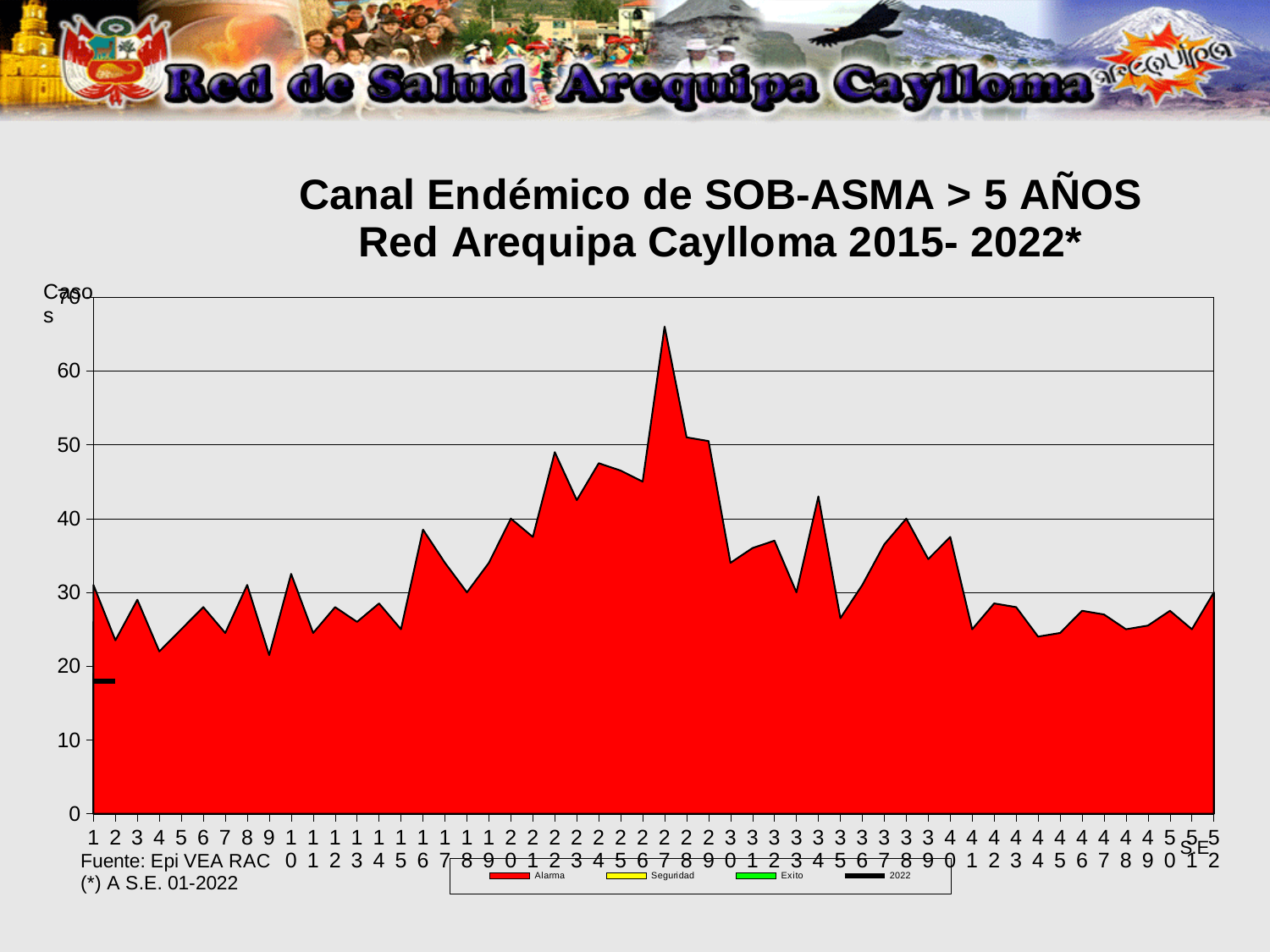
Is the Alarma value at week 45 greater or less than 30? less How many epidemiological weeks are shown along the x axis? 52 At which week does the Alarma area reach its highest value? 27 What is the title of the chart? Canal Endémico de SOB-ASMA > 5 AÑOS Red Arequipa Caylloma 2015- 2022* Is the Alarma value at week 4 greater or less than 30? less Is the Alarma value at week 22 greater or less than 40? greater Which is larger, the Alarma value at week 27 or at week 40? Week 27 Which series is shown in red in the legend? Alarma What kind of chart is shown on the slide? Area chart How many series does the legend list? 4